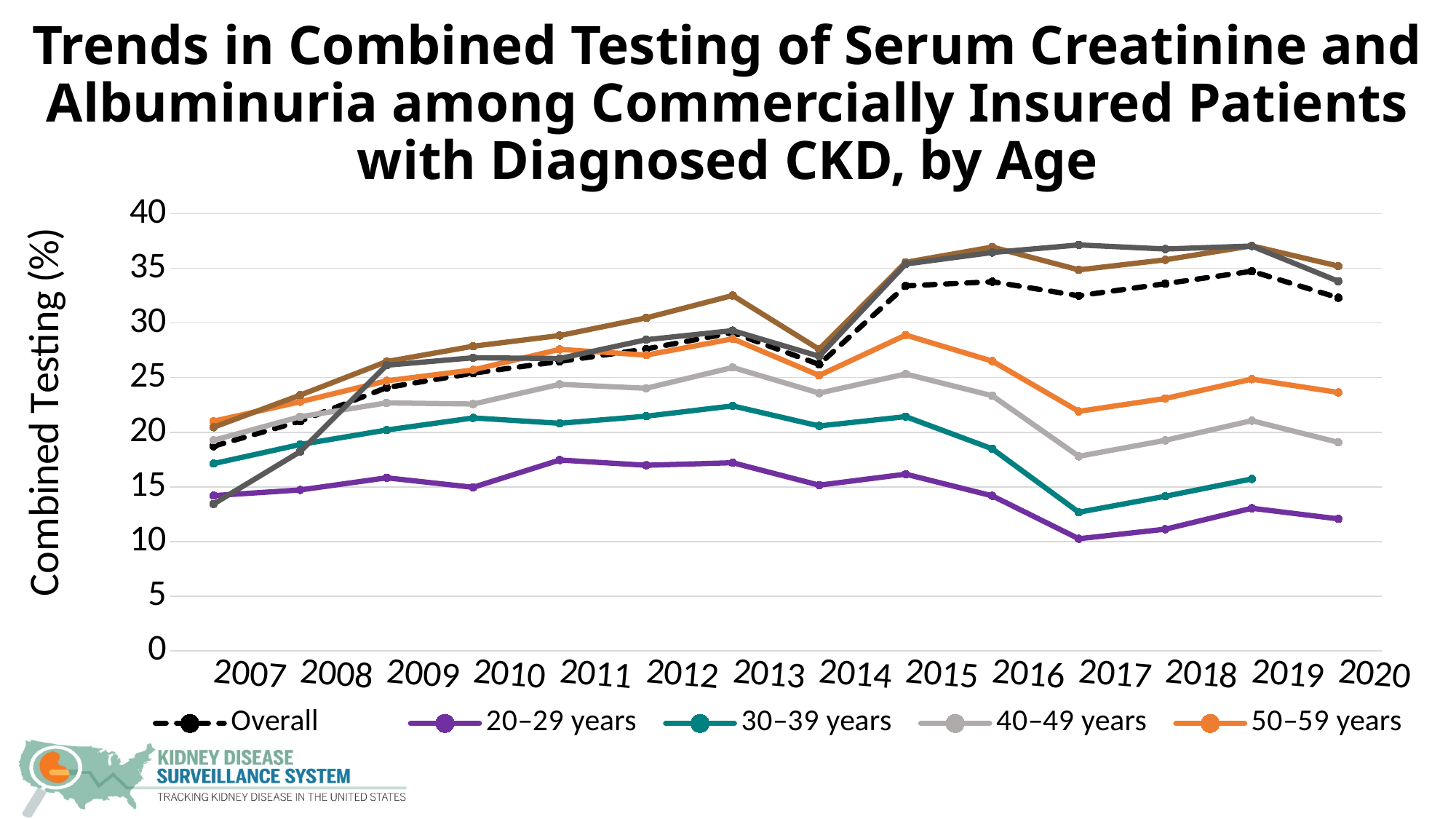
How many years are shown along the x axis? 14 What kind of chart is shown on the slide? line chart Does the Overall series rise or fall from 2007 to 2013? rise In which year is the 20–29 years series at its lowest? 2017 Is the value for 40–49 years in 2017 greater or less than 20? less Is the Overall value in 2019 greater or less than 30? greater Does the 30–39 years series rise or fall from 2015 to 2017? fall In 2015, which is larger: the value for 50–59 years or the value for 30–39 years? 50–59 years What is the label on the y axis? Combined Testing (%) How many series does the legend list? 5 Is the value for 20–29 years in 2017 greater or less than 15? less